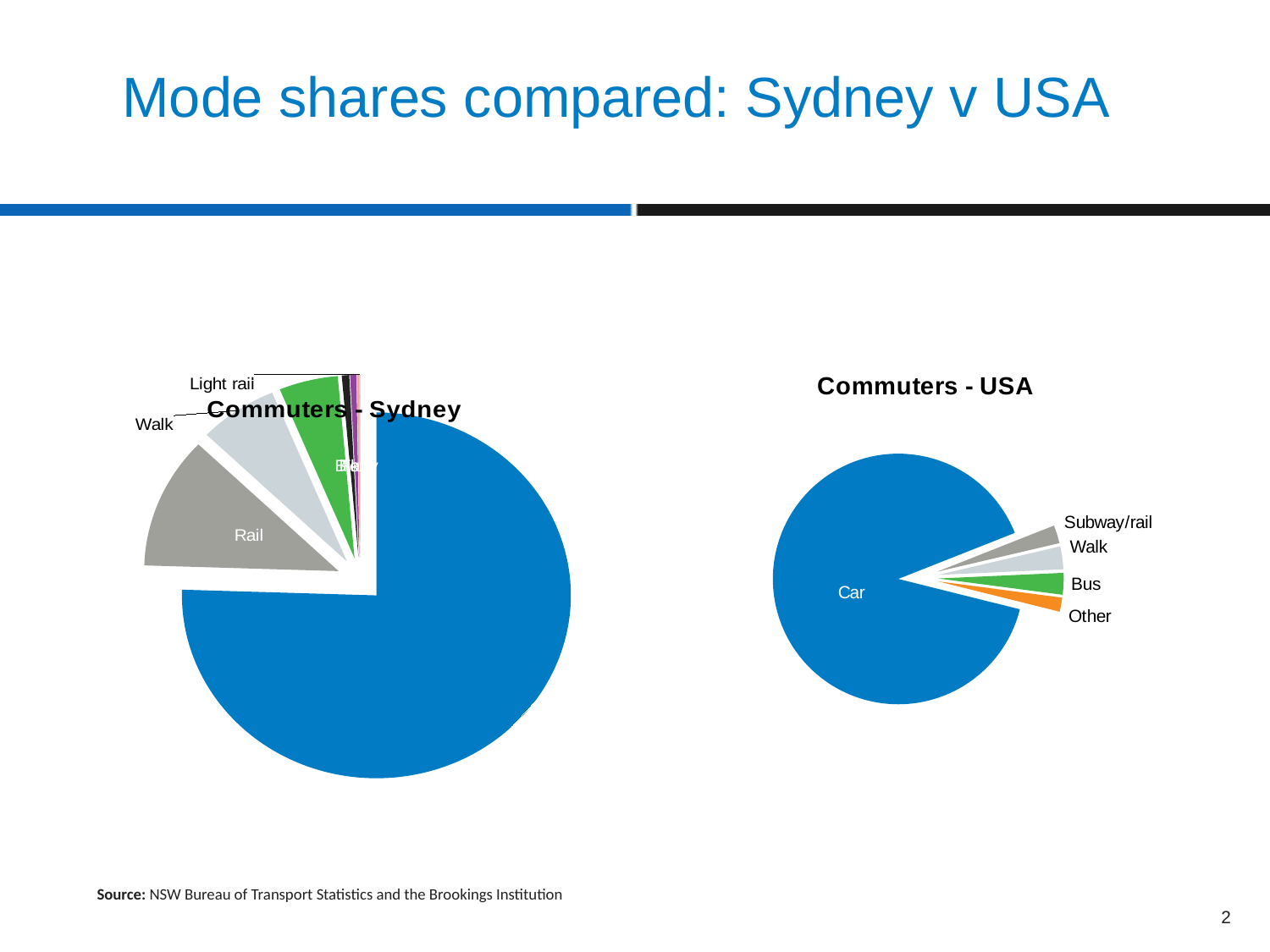
What is the title of the pie chart on the left of the slide? Commuters - Sydney In the "Commuters - Sydney" chart, which is larger, Rail or Walk? Rail What type of chart is the "Commuters - Sydney" chart? pie chart In the "Commuters - USA" chart, which is larger, Car or Subway/rail? Car In the "Commuters - USA" chart, which is larger, Car or Bus? Car In the "Commuters - USA" chart, which mode has the largest share? Car What type of chart is the "Commuters - USA" chart? pie chart What is the title of the pie chart on the right of the slide? Commuters - USA How many slices are labelled in the "Commuters - USA" chart? 5